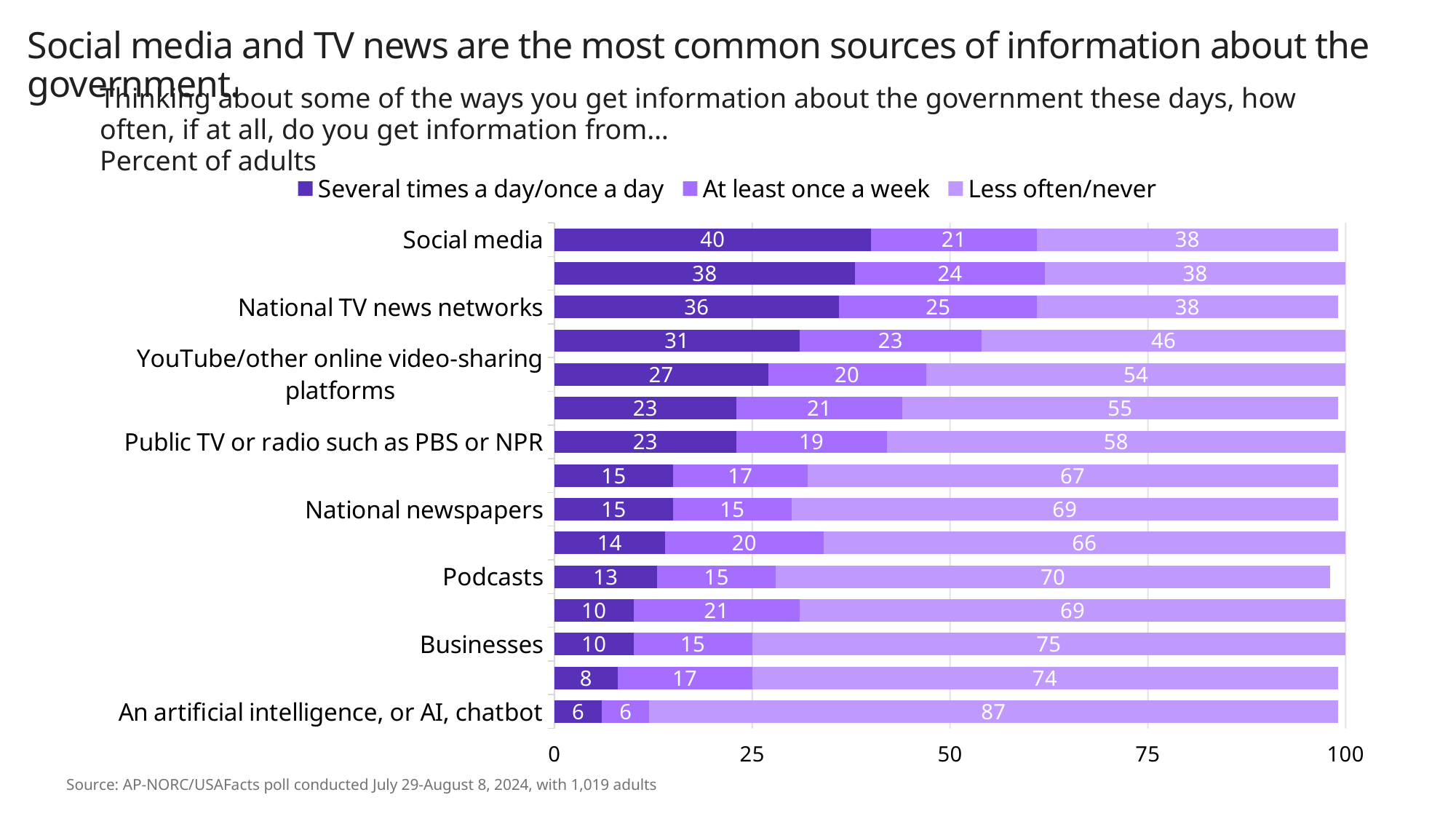
Is the 'Less often/never' value for National newspapers greater or less than 50? greater Which labeled source has the highest 'Several times a day/once a day' value? Social media Which labeled source has the lowest 'Several times a day/once a day' value? An artificial intelligence, or AI, chatbot What kind of chart is shown on the slide? Stacked bar chart What is the 'Less often/never' value for an artificial intelligence, or AI, chatbot? 87 Which is larger: the 'Several times a day/once a day' value for YouTube/other online video-sharing platforms or for Public TV or radio such as PBS or NPR? YouTube/other online video-sharing platforms What is the third legend entry? Less often/never What is the 'At least once a week' value for National TV news networks? 25 How many series does the legend list? 3 What is the difference between the 'Less often/never' values for Businesses and Podcasts? 5 What percentage of adults get information about the government from social media several times a day/once a day? 40 What is the total of the three segments for the Social media bar? 99